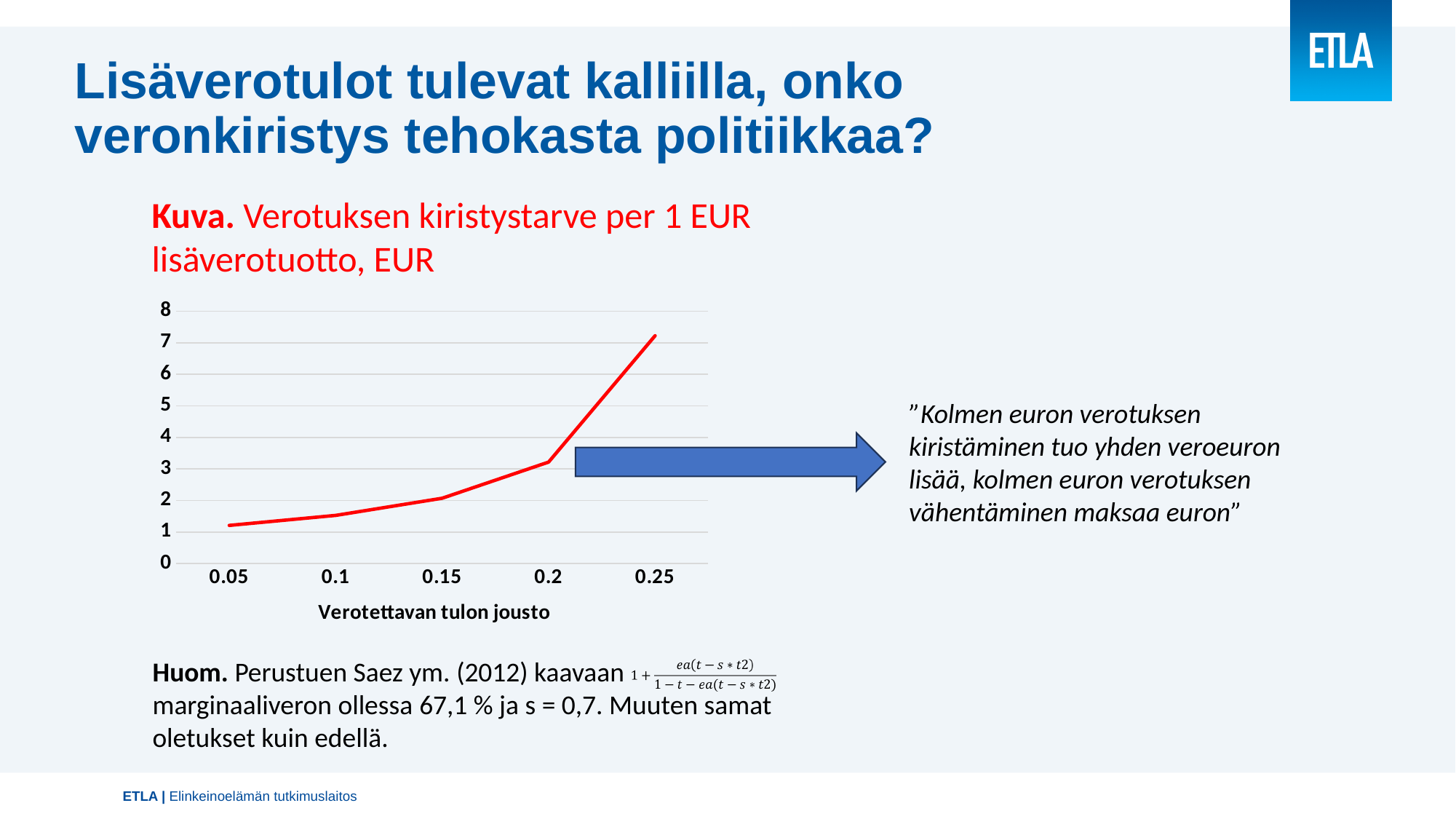
At which x-axis value is the plotted value lowest? 0.05 What is the label of the x axis of the chart? Verotettavan tulon jousto What kind of chart is shown on the slide? line chart What colour is the plotted line in the chart? red Do the values rise or fall as the elasticity (Verotettavan tulon jousto) increases along the x axis? rise At which x-axis value is the plotted value highest? 0.25 How many points are plotted along the x axis of the chart? 5 Which has the larger value, 0.2 or 0.25? 0.25 Is the value at 0.2 greater or less than 3? greater Is the value at 0.25 greater or less than 7? greater Is the value at 0.05 greater or less than 2? less